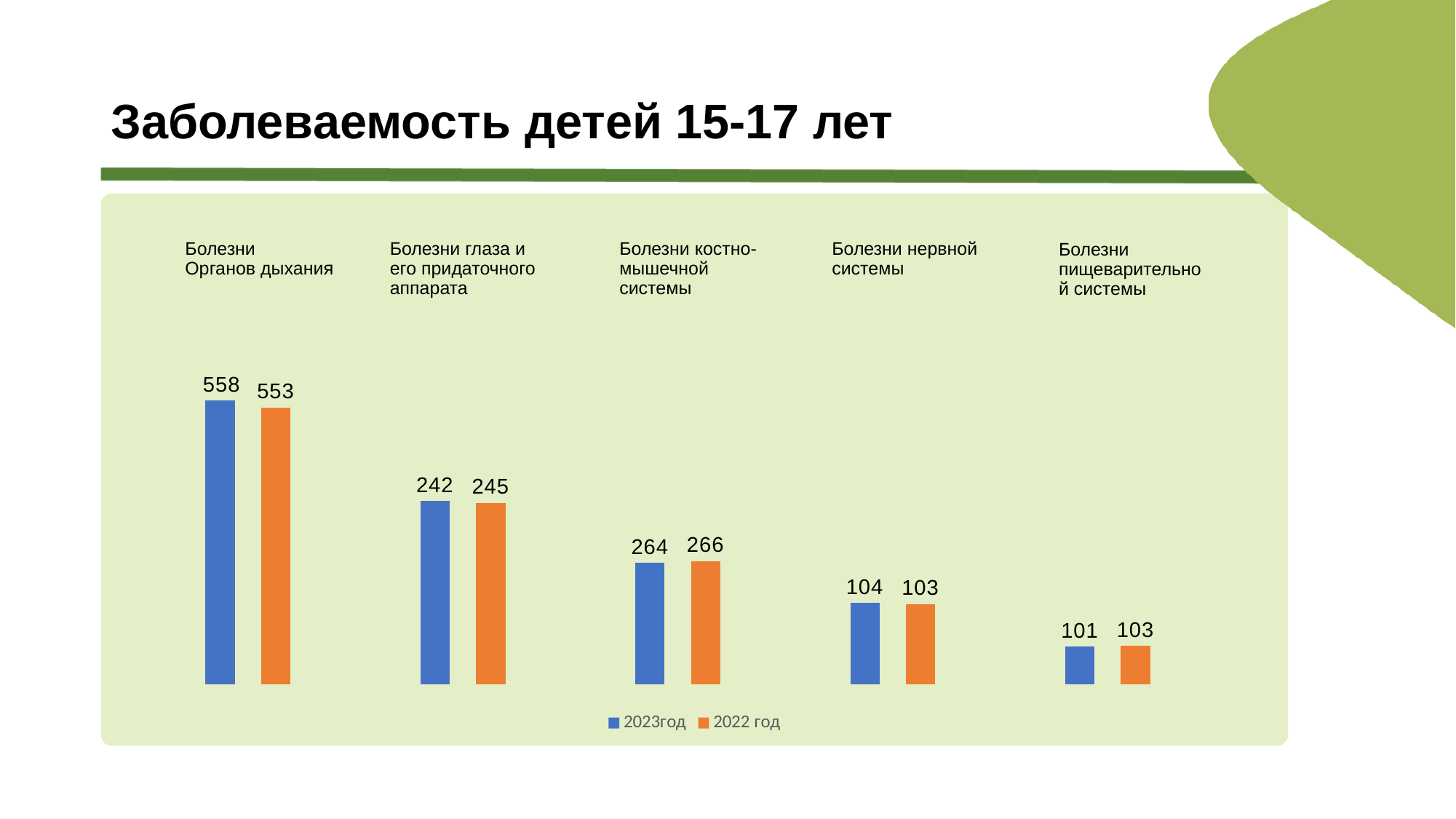
What is the 2022 value for Болезни пищеварительной системы? 103 What is the difference between the 2023 and 2022 values for Болезни органов дыхания? 5 What is the 2022 value for Болезни глаза и его придаточного аппарата? 245 Which is larger for Болезни костно-мышечной системы: the 2023 value or the 2022 value? 2022 value What is the difference between the 2023 values for Болезни костно-мышечной системы and Болезни нервной системы? 160 Which category has the highest 2023 value? Болезни органов дыхания How many disease categories are shown in the chart? 5 What is the 2023 value for Болезни костно-мышечной системы? 264 What is the 2023 value for Болезни органов дыхания? 558 What type of chart is shown on the slide? Bar chart Which category has the lowest 2023 value? Болезни пищеварительной системы How many series does the legend list? 2